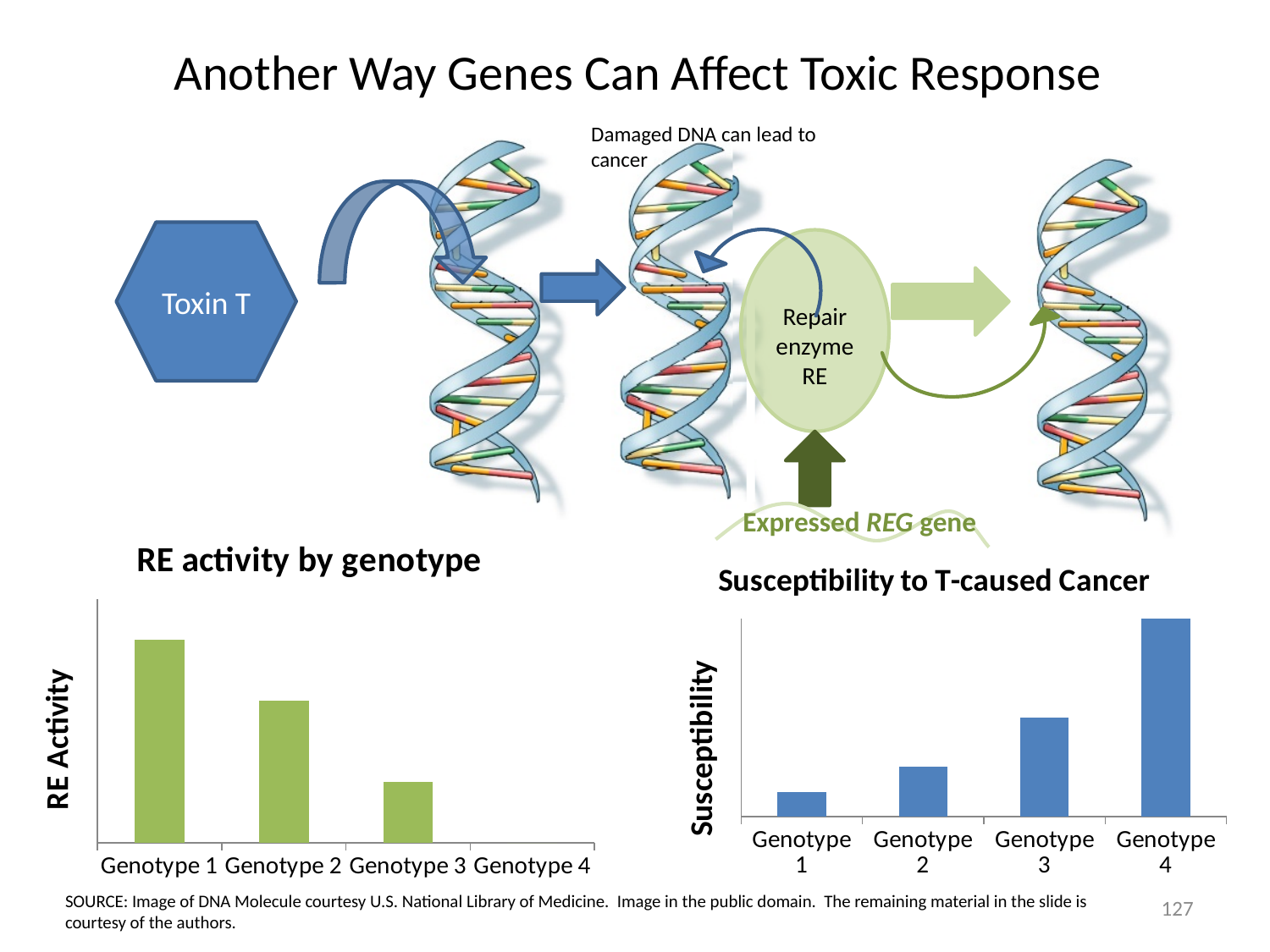
In the 'Susceptibility to T-caused Cancer' chart, which genotype has the highest susceptibility? Genotype 4 In the 'RE activity by genotype' chart, which genotype has the highest RE activity? Genotype 1 In the 'RE activity by genotype' chart, which genotype has the lowest RE activity? Genotype 4 What is the y-axis label of the 'RE activity by genotype' chart? RE Activity In the 'Susceptibility to T-caused Cancer' chart, which has higher susceptibility, Genotype 2 or Genotype 3? Genotype 3 In the 'RE activity by genotype' chart, which has higher RE activity, Genotype 2 or Genotype 3? Genotype 2 How many genotype categories are shown on the x axis of the 'RE activity by genotype' chart? 4 In the 'Susceptibility to T-caused Cancer' chart, which genotype has the lowest susceptibility? Genotype 1 What kind of chart is the 'RE activity by genotype' chart? Bar chart In the 'RE activity by genotype' chart, do the values rise or fall from Genotype 1 to Genotype 4? Fall In the 'Susceptibility to T-caused Cancer' chart, do the values rise or fall from Genotype 1 to Genotype 4? Rise What kind of chart is the 'Susceptibility to T-caused Cancer' chart? Bar chart